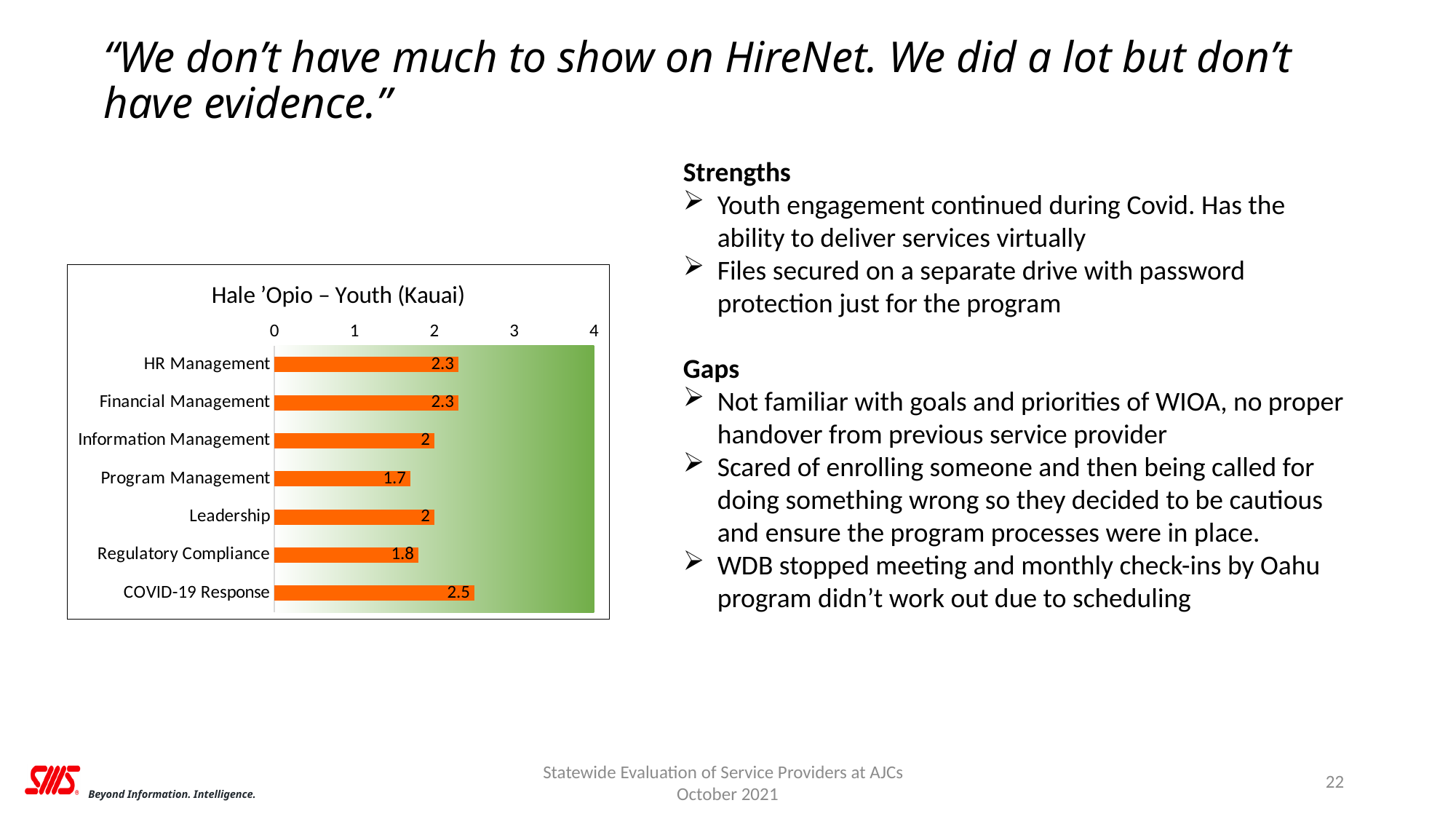
What kind of chart is shown on the slide? bar chart How many categories are shown in the chart? 7 Which category has the highest value? COVID-19 Response Which category has the lowest value? Program Management Which is larger, the value for HR Management or the value for Leadership? HR Management What is the value for Financial Management? 2.3 Is the value for Information Management greater or less than 3? less What is the value for Program Management? 1.7 What is the value for Regulatory Compliance? 1.8 What is the difference between the values for COVID-19 Response and Program Management? 0.8 What is the title of the chart? Hale ’Opio – Youth (Kauai) What is the value for COVID-19 Response? 2.5